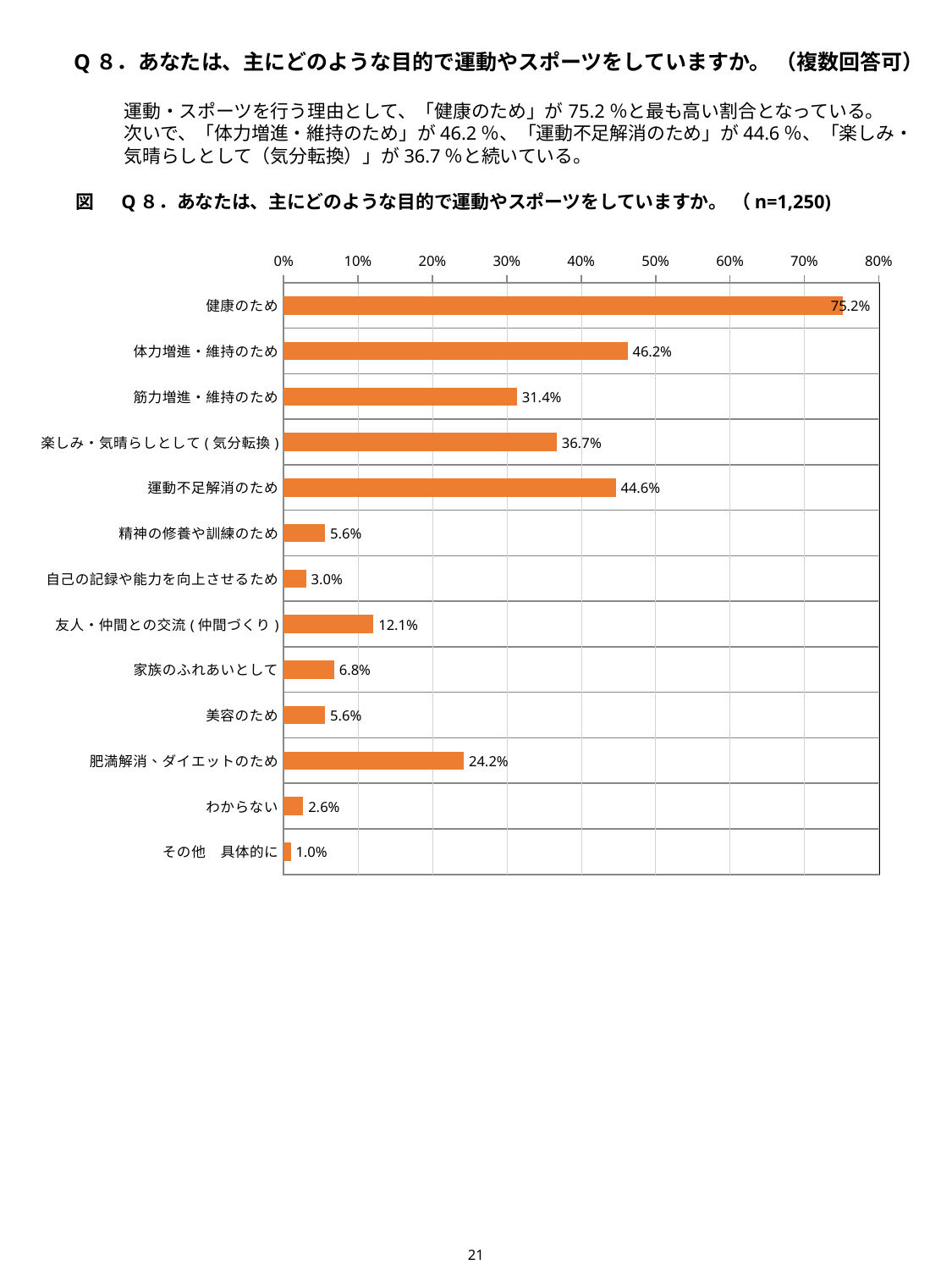
Is the value for 友人・仲間との交流(仲間づくり) greater or less than 10%? greater What kind of chart is this? bar chart What is the sample size (n) shown in the chart title? 1,250 What is the maximum value shown on the x axis? 80% How many categories are shown in the chart? 13 Which category has the highest value? 健康のため What is the value for 健康のため? 75.2% What is the value for 運動不足解消のため? 44.6% What is the value for 肥満解消、ダイエットのため? 24.2% Which category has the lowest value? その他 具体的に Which is larger, 楽しみ・気晴らしとして(気分転換) or 運動不足解消のため? 運動不足解消のため What is the difference between 体力増進・維持のため and 筋力増進・維持のため? 14.8%